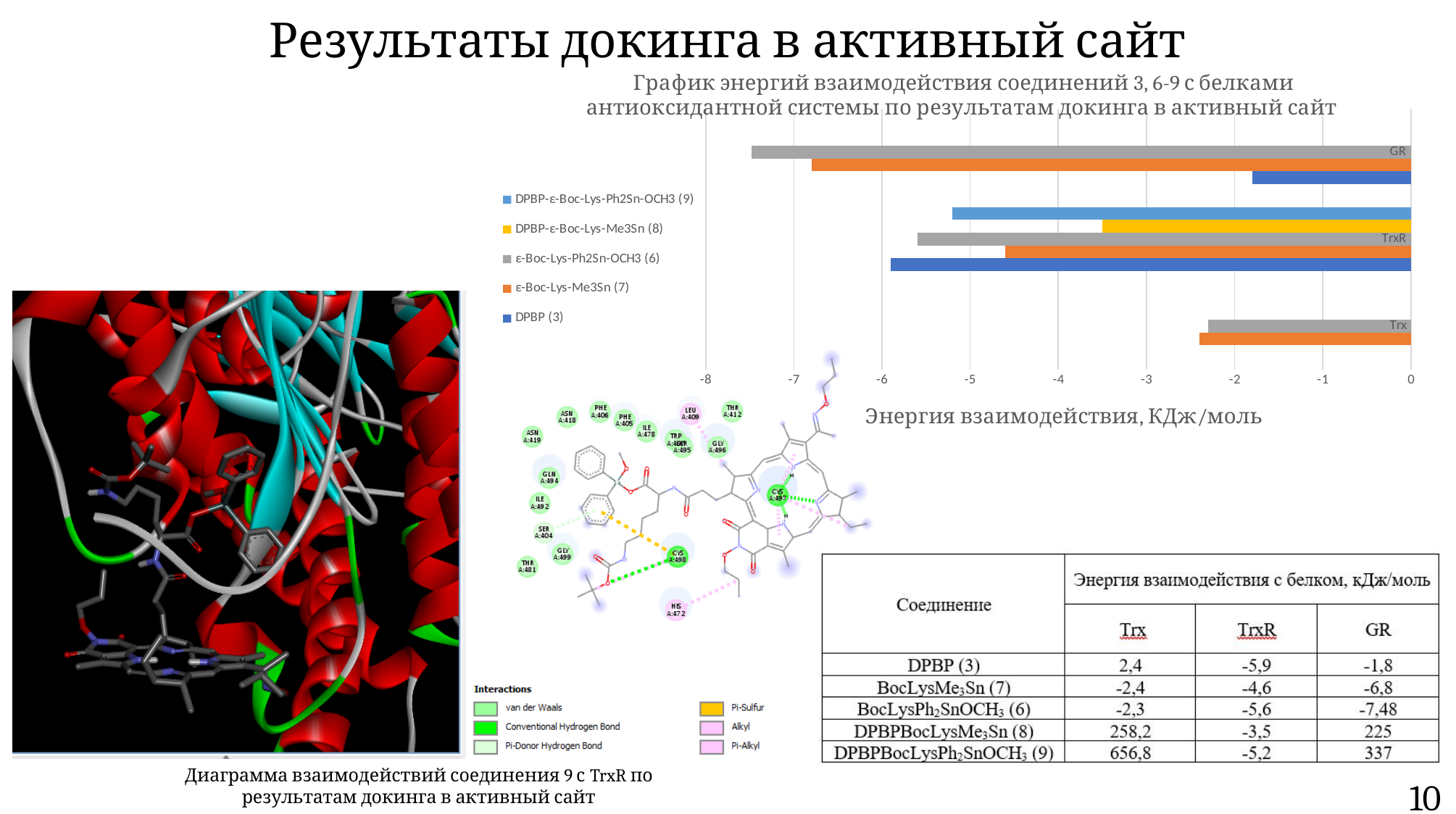
How many protein categories are shown on the chart's vertical axis? 3 Is the value for DPBP-ε-Boc-Lys-Me3Sn (8) with TrxR greater or less than -4? greater Is the value for DPBP (3) with GR greater or less than -2? greater What kind of chart is shown on the slide? bar chart What is the title of the chart's horizontal axis? Энергия взаимодействия, КДж/моль Is the value for ε-Boc-Lys-Ph2Sn-OCH3 (6) with GR greater or less than -7? less Which series in the legend is shown in orange? ε-Boc-Lys-Me3Sn (7) For GR, which series has the longest bar (most negative interaction energy)? ε-Boc-Lys-Ph2Sn-OCH3 (6) For TrxR, which bar is longer: DPBP (3) or DPBP-ε-Boc-Lys-Me3Sn (8)? DPBP (3) How many series does the chart legend list? 5